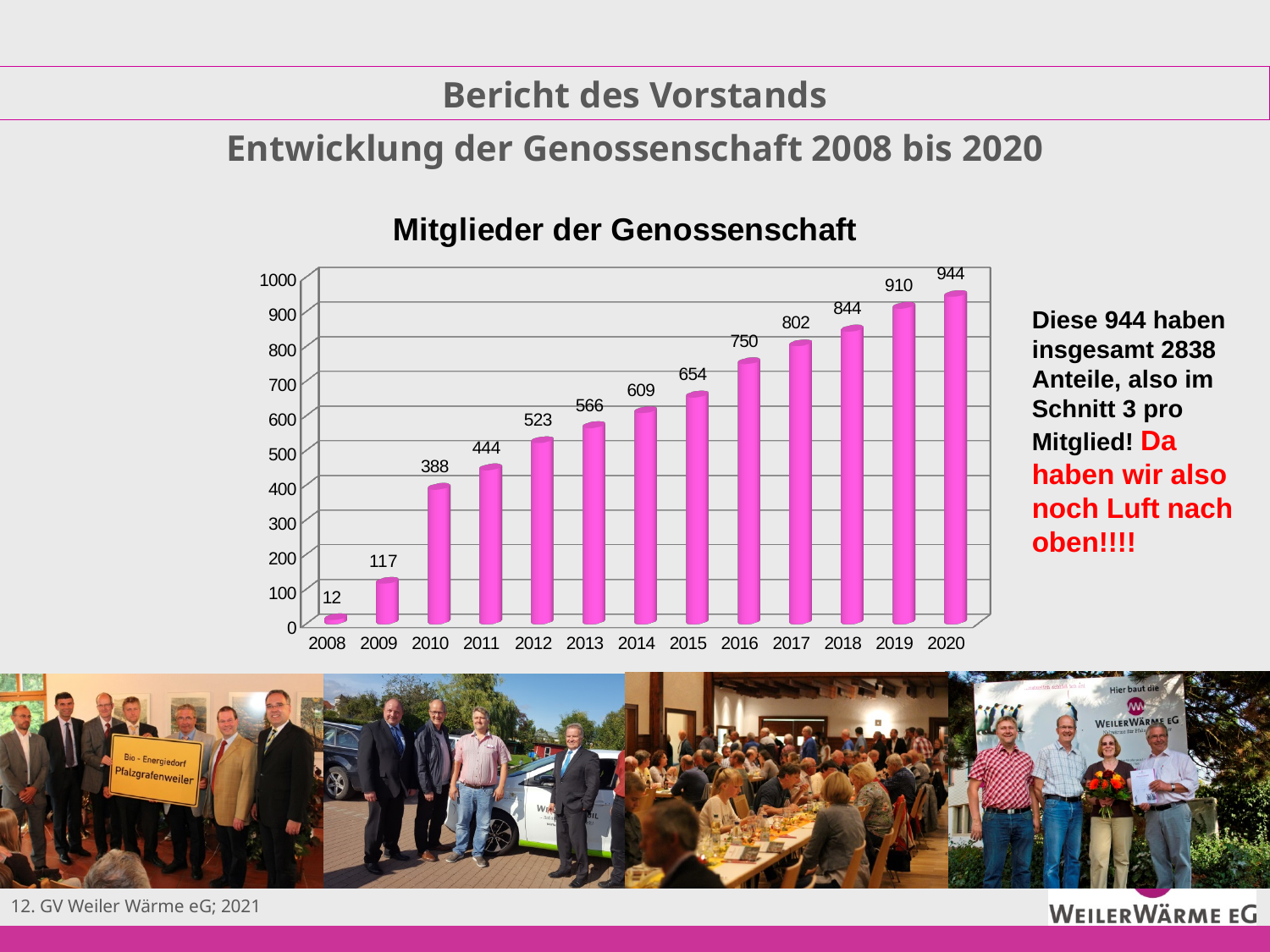
What is the value for 2016 in the chart? 750 What is the difference between the values for 2012 and 2011? 79 What is the difference between the values for 2020 and 2019? 34 Which is larger, the value for 2014 or the value for 2013? 2014 Which year has the lowest value in the chart? 2008 What kind of chart is shown on the slide? bar chart What is the value for 2010 in the chart 'Mitglieder der Genossenschaft'? 388 Is the value for 2017 greater or less than 700? greater How many years are shown on the x axis of the chart? 13 What is the value for 2008 in the chart? 12 Which year has the highest value in the chart? 2020 Do the values rise or fall from 2008 to 2020? rise